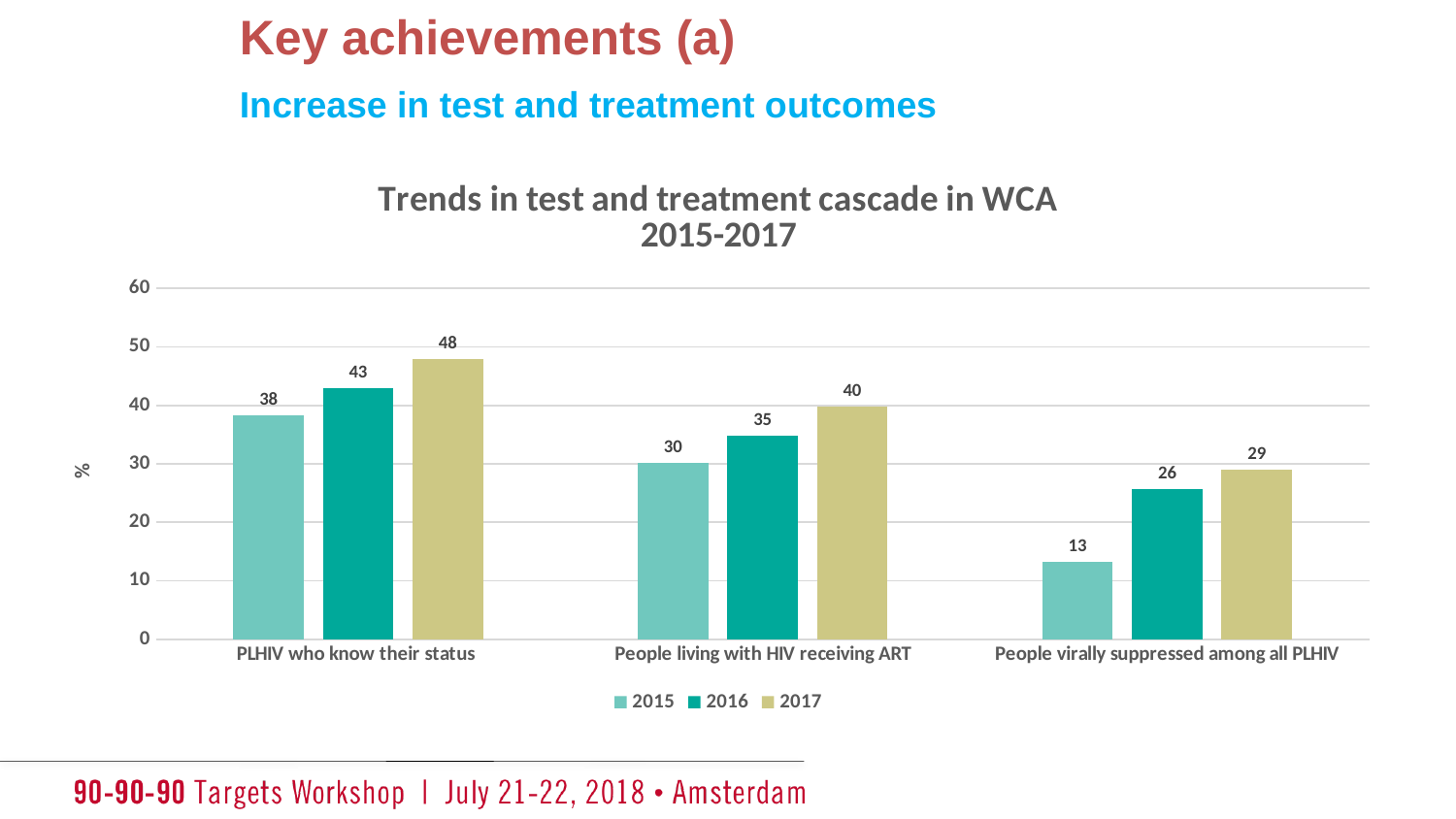
What is the difference between the 2017 and 2015 values for People virally suppressed among all PLHIV? 16 Within each category, do the values rise or fall from 2015 to 2017? Rise How many categories are shown on the x axis? 3 What kind of chart is shown? Bar chart Which category has the highest 2017 value? PLHIV who know their status Which category has the lowest 2015 value? People virally suppressed among all PLHIV How many series does the legend list? 3 Which is larger: the 2016 value for PLHIV who know their status or the 2017 value for People living with HIV receiving ART? 2016 value for PLHIV who know their status What is the title of the chart? Trends in test and treatment cascade in WCA 2015-2017 What is the 2016 value for People living with HIV receiving ART? 35 What is the 2015 value for People virally suppressed among all PLHIV? 13 What is the 2017 value for PLHIV who know their status? 48